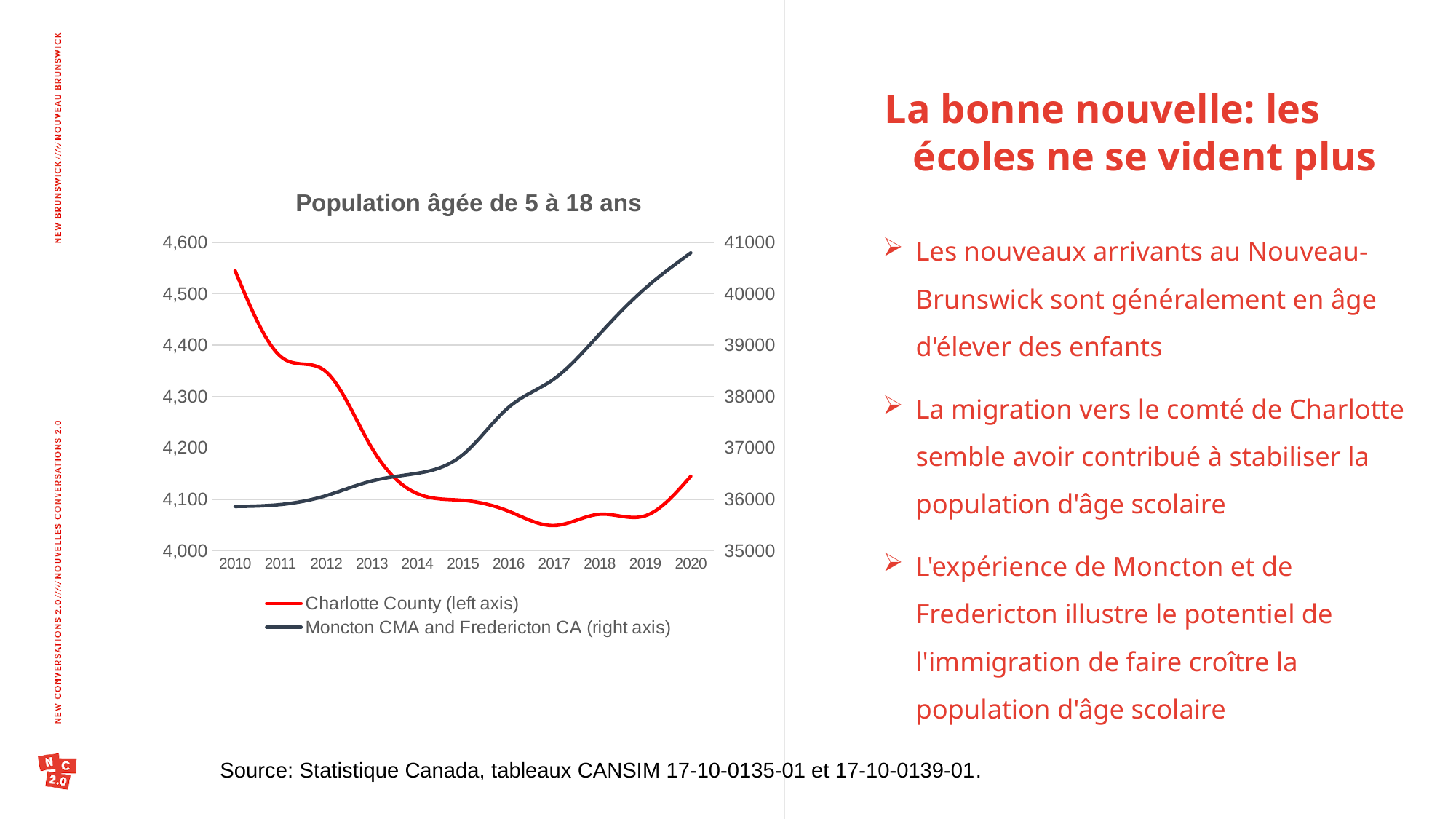
What kind of chart is shown on the slide? line chart Does the Moncton CMA and Fredericton CA series rise or fall from 2010 to 2020? rise Is the Moncton CMA and Fredericton CA value for 2020 greater or less than 40000? greater Does the Charlotte County series rise or fall from 2010 to 2017? fall Is the Charlotte County value for 2010 greater or less than 4,500? greater How many years are plotted along the x axis of the chart? 11 In which year is the Charlotte County value highest? 2010 Which axis does the Charlotte County series use, according to the legend? left axis How many series does the legend of the chart list? 2 In which year is the Charlotte County value lowest? 2017 In which year is the Moncton CMA and Fredericton CA value highest? 2020 What is the title of the chart? Population âgée de 5 à 18 ans